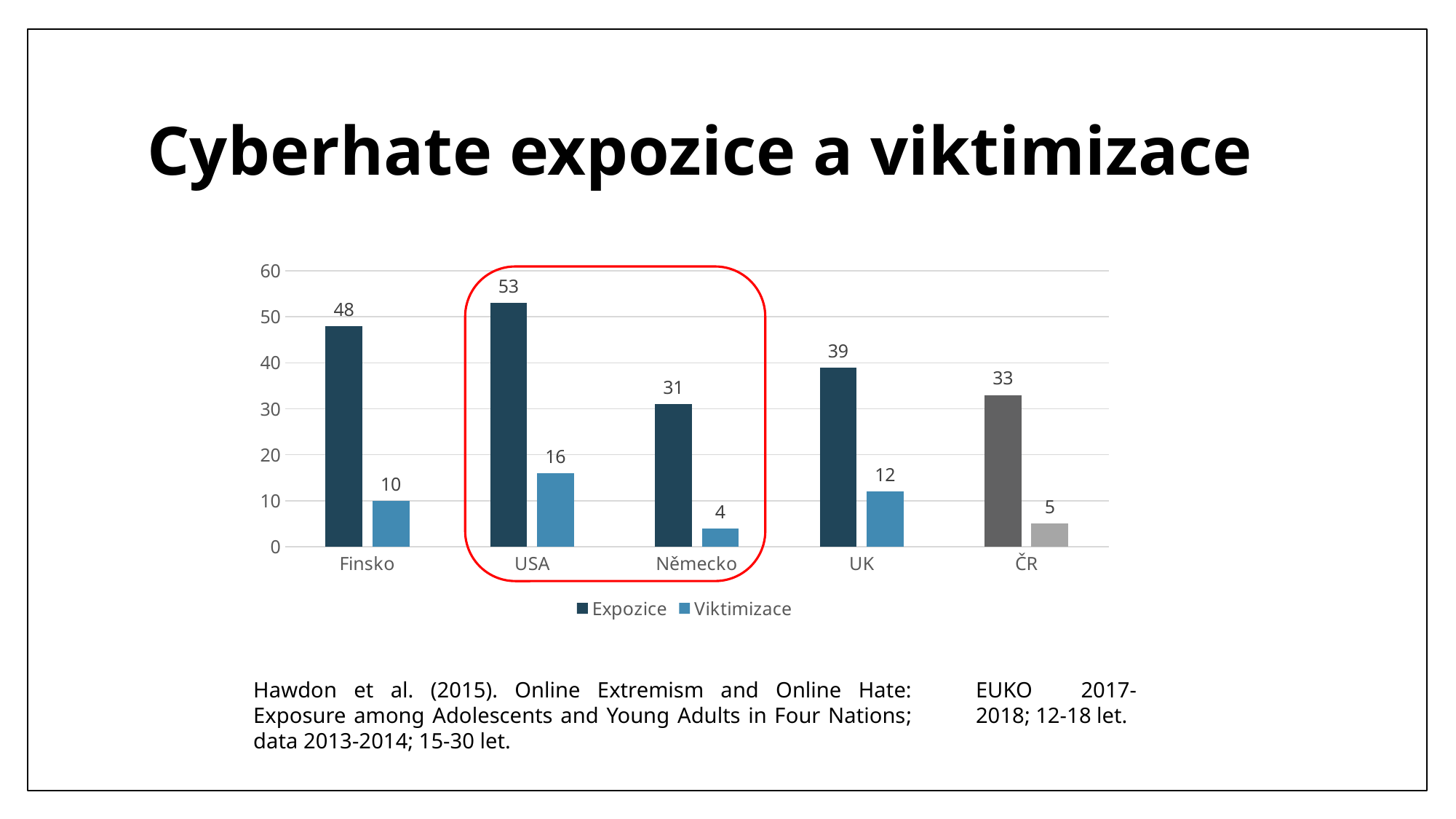
What kind of chart is shown on the slide? bar chart What is the Expozice value for ČR? 33 What is the Expozice value for Finsko? 48 Which country has the lowest Viktimizace value? Německo How many countries are shown on the x axis? 5 Which country has the highest Expozice value? USA How many series does the legend list? 2 Which is larger, the Viktimizace value for USA or for UK? USA Which two countries are enclosed by the red outline on the chart? USA and Německo What is the difference between the Expozice and Viktimizace values for UK? 27 What is the Viktimizace value for Německo? 4 Is the Expozice value for Německo greater or less than 40? less